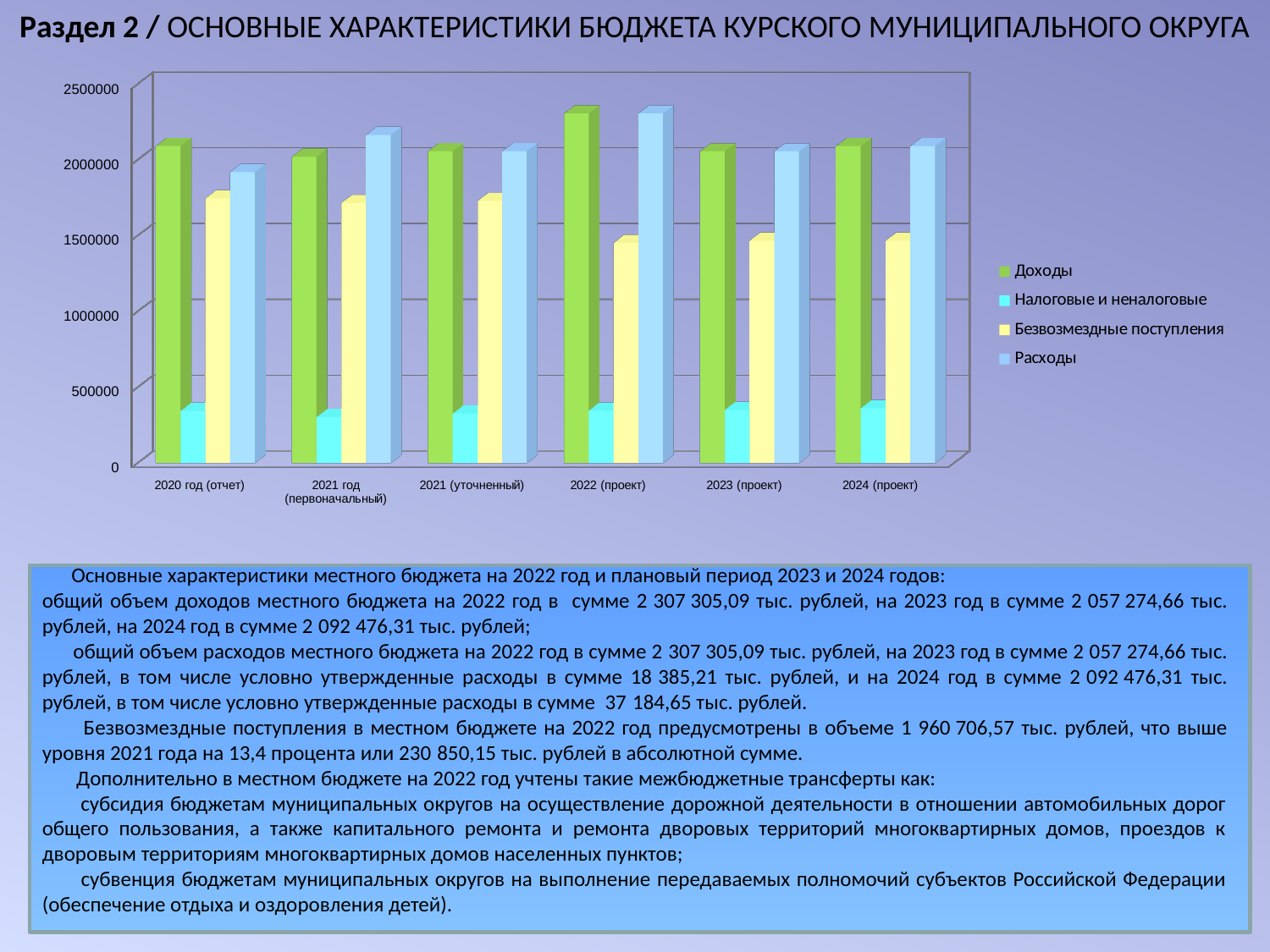
Is the value for Налоговые и неналоговые in 2020 год (отчет) greater or less than 500000? less How many categories (years) are shown along the x axis of the chart? 6 What colour are the bars for the Доходы series? Green Is the value for Безвозмездные поступления in 2020 год (отчет) greater or less than 1500000? greater Is the value for Расходы in 2021 год (первоначальный) greater or less than 2000000? greater In which category is the value for Доходы the highest? 2022 (проект) What kind of chart is shown on the slide? Bar chart How many series does the chart legend list? 4 Which is larger: Доходы in 2022 (проект) or Доходы in 2020 год (отчет)? 2022 (проект) Which is larger: Безвозмездные поступления in 2020 год (отчет) or in 2022 (проект)? 2020 год (отчет) Which series has the lowest values across all categories? Налоговые и неналоговые